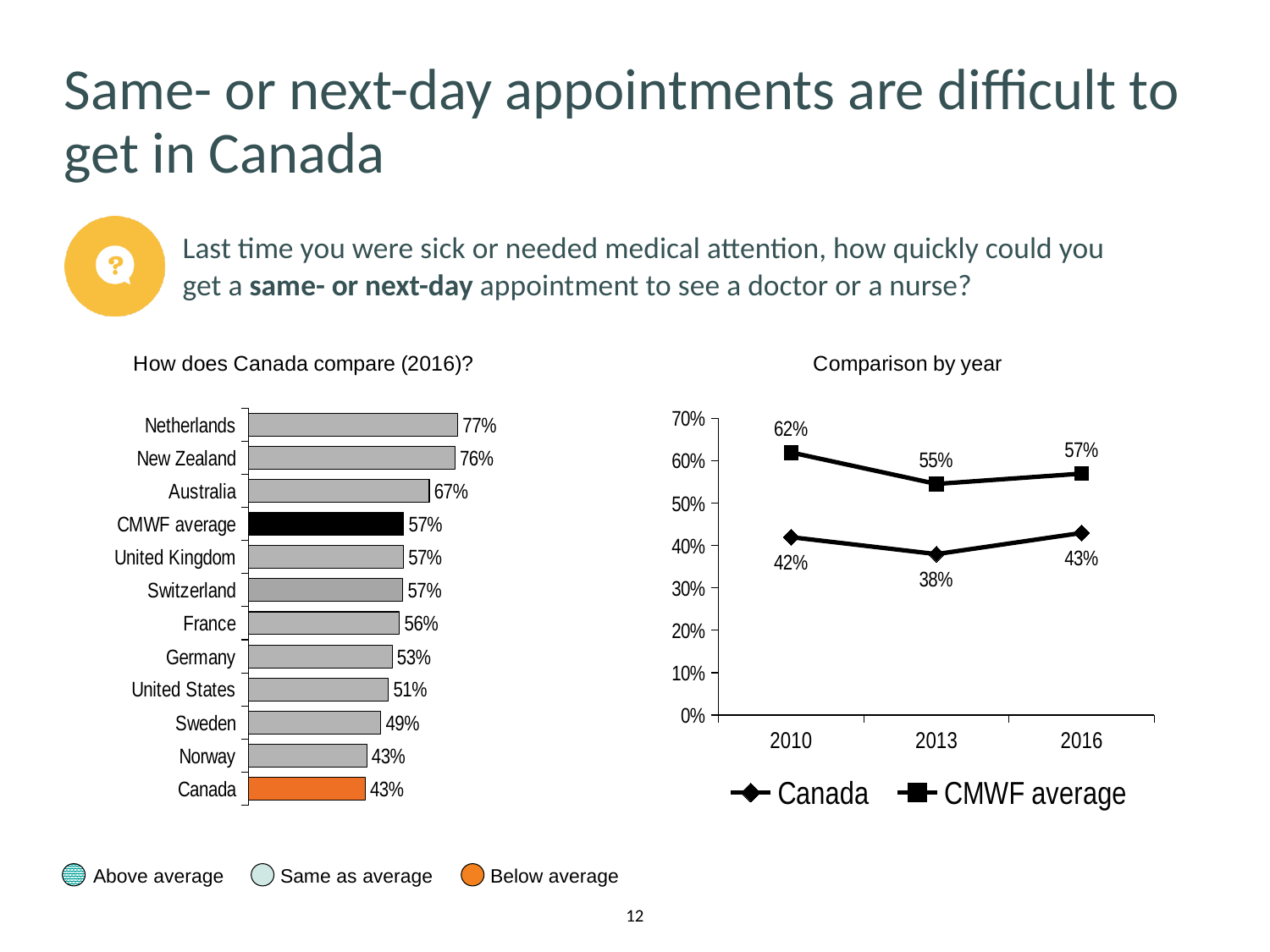
In the 'Comparison by year' chart, what is the value for Canada in 2013? 38% How many series does the legend of the 'Comparison by year' chart list? 2 In the 'How does Canada compare (2016)?' chart, what is the value for the United States? 51% In the 'How does Canada compare (2016)?' chart, which country has the highest value? Netherlands In the 'Comparison by year' chart, what is the value for the CMWF average in 2010? 62% What kind of chart is the 'Comparison by year' chart? Line chart In the 'How does Canada compare (2016)?' chart, what is the difference between the Netherlands and Canada? 34% In the 'How does Canada compare (2016)?' chart, which is larger, the value for Germany or the value for Sweden? Germany In the 'Comparison by year' chart, what is the difference between the CMWF average and Canada in 2016? 14% In the 'How does Canada compare (2016)?' chart, how many countries or categories are listed? 12 What kind of chart is the 'How does Canada compare (2016)?' chart? Bar chart In the 'How does Canada compare (2016)?' chart, what is the value for Australia? 67%